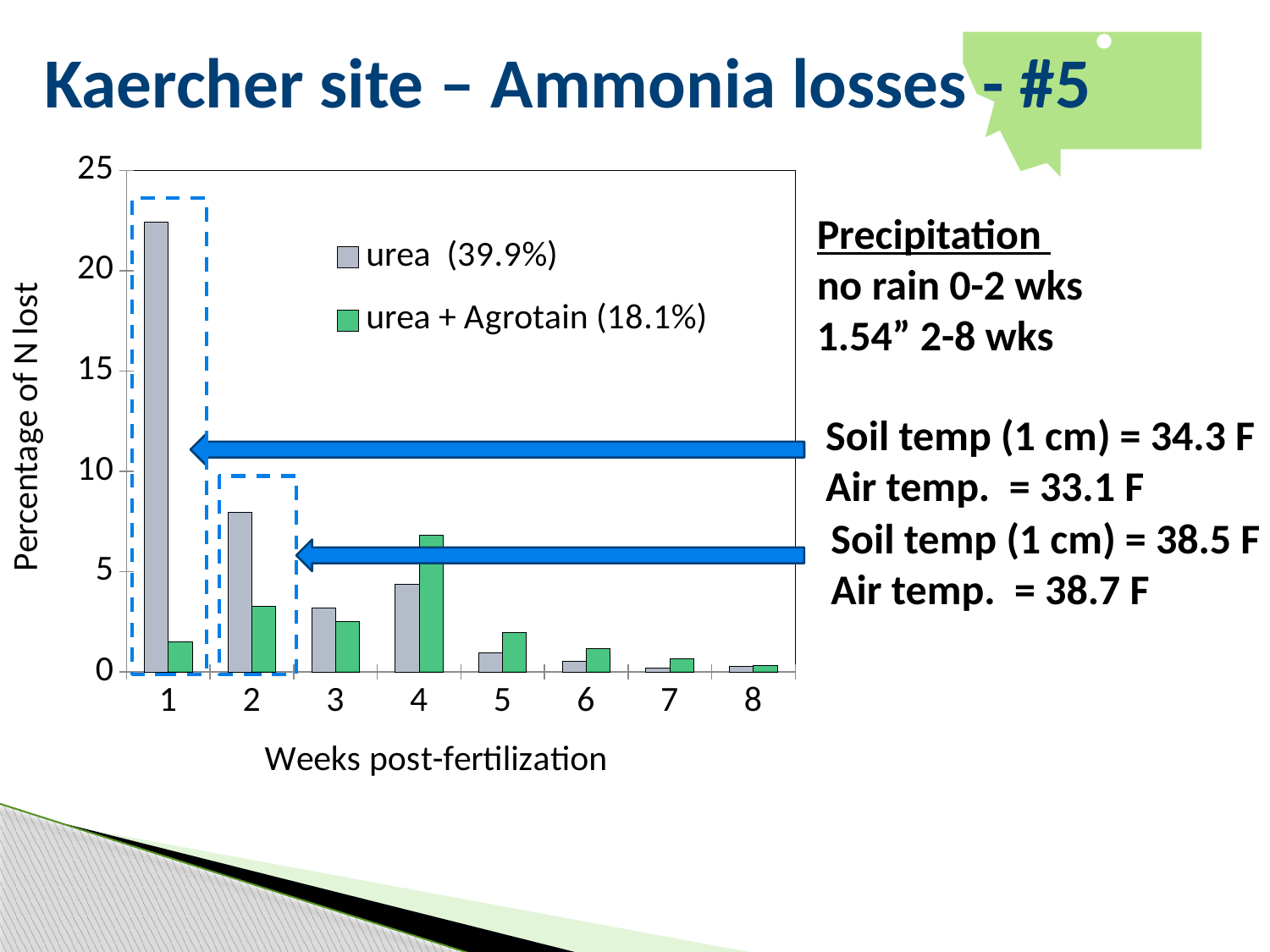
In week 4, which series has the larger value, urea or urea + Agrotain? urea + Agrotain How many weeks post-fertilization are shown on the x axis of the chart? 8 Is the urea value for week 2 greater or less than 10? less Is the urea + Agrotain value for week 4 greater or less than 5? greater How many series does the chart's legend list? 2 Does the urea series generally rise or fall from week 1 to week 8? fall Is the urea value for week 1 greater or less than 20? greater What is the label on the y axis of the chart? Percentage of N lost In week 1, which series has the larger value, urea or urea + Agrotain? urea What kind of chart is shown on the slide? bar chart In which week is the urea + Agrotain series highest? 4 In which week is the urea series highest? 1